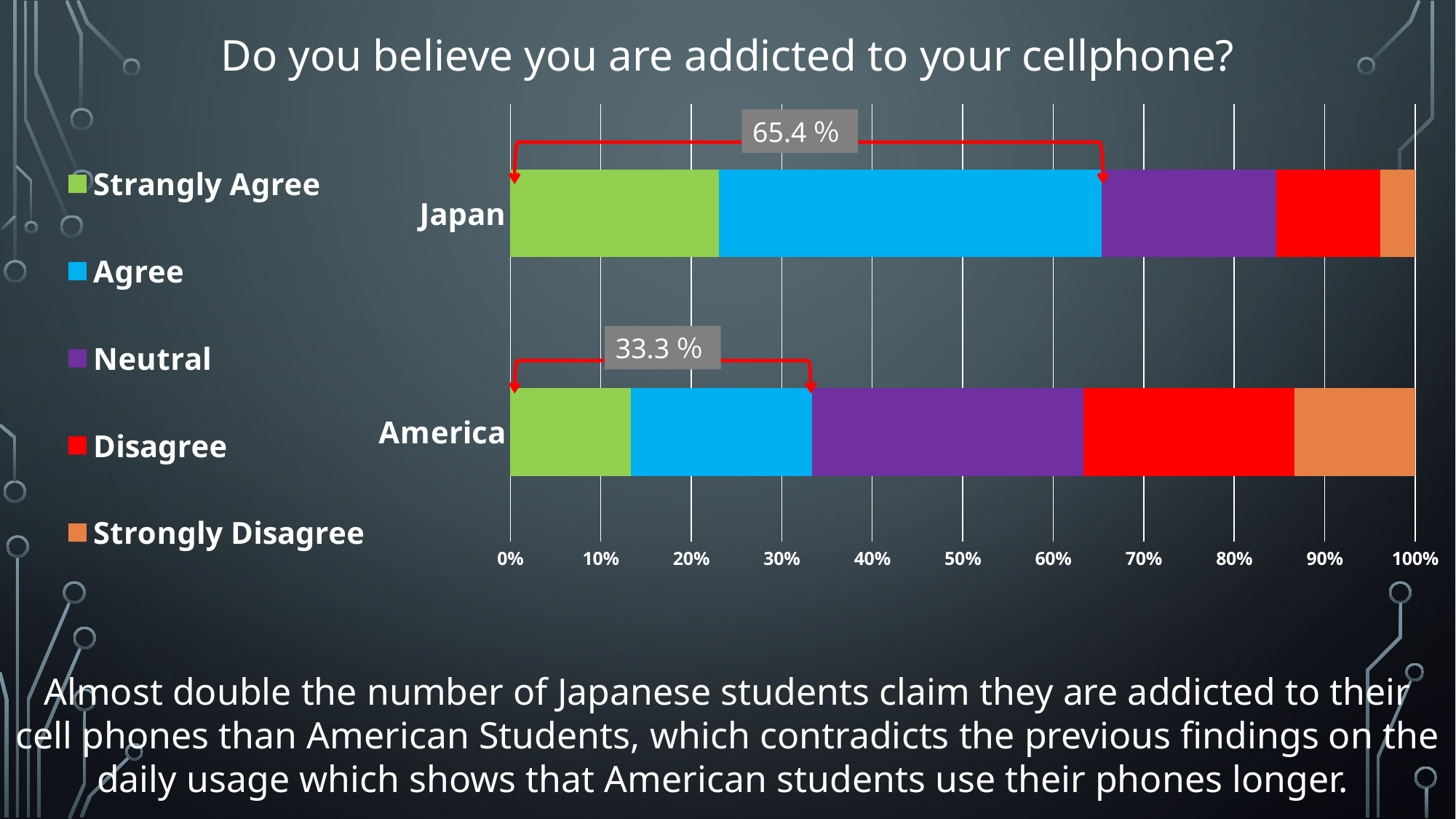
How many series does the legend list? 5 Which country has the larger Neutral segment, Japan or America? America Which legend entry is shown in orange? Strongly Disagree What kind of chart is shown on the slide? stacked bar chart What combined percentage is labelled for America's Strongly Agree and Agree responses? 33.3 % What is the title of the chart? Do you believe you are addicted to your cellphone? Which country has the larger Agree segment, Japan or America? Japan How many countries (categories) are plotted in the chart? 2 Is the Strongly Disagree share for Japan greater or less than 10%? less What combined percentage is labelled for Japan's Strongly Agree and Agree responses? 65.4 % What is the difference between the labelled combined agree percentages for Japan (65.4 %) and America (33.3 %)? 32.1 % Is the Strongly Agree share for Japan greater or less than 20%? greater